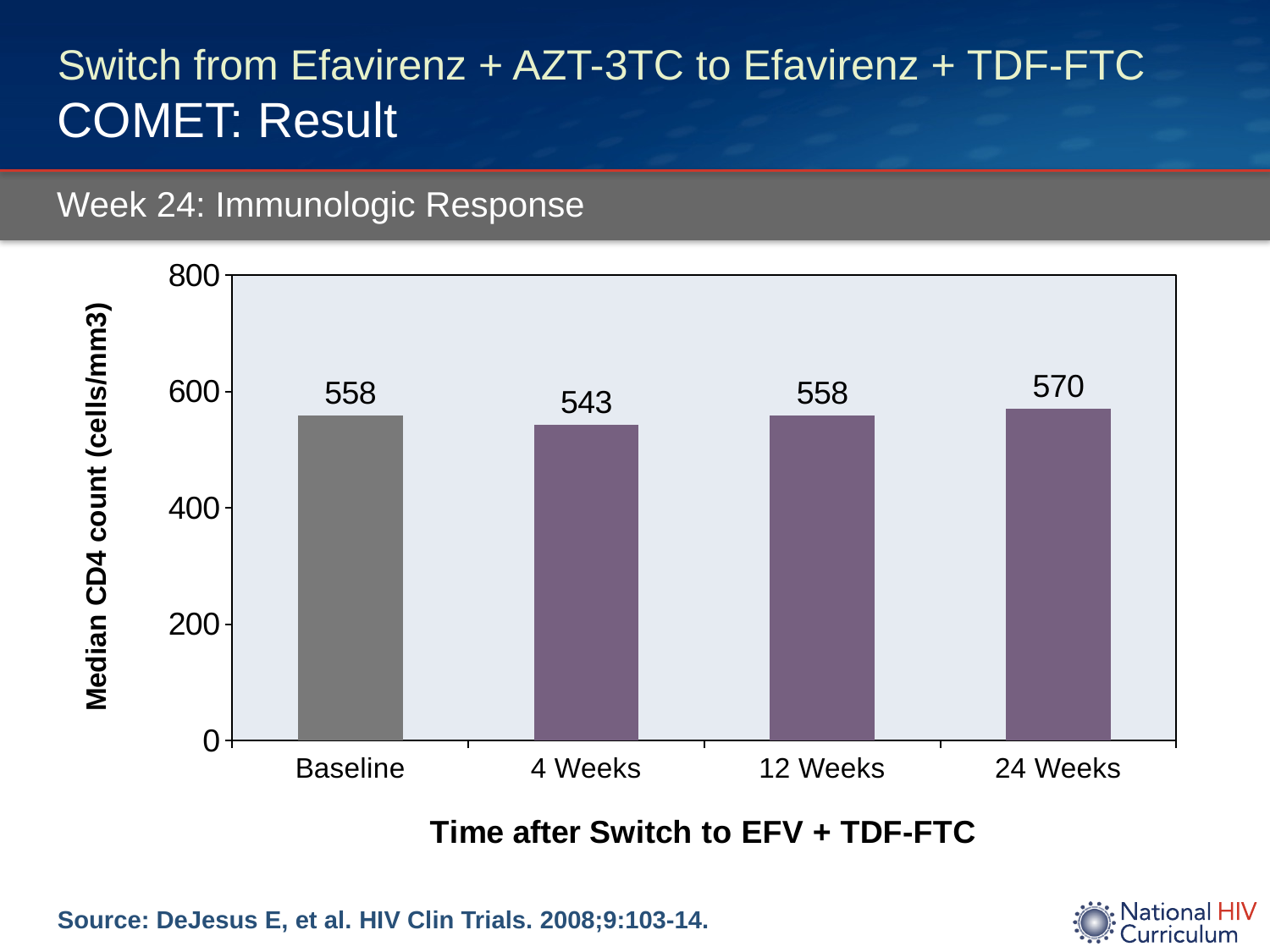
Which time point has the highest median CD4 count? 24 Weeks What is the label of the x axis? Time after Switch to EFV + TDF-FTC What is the difference in median CD4 count between 24 Weeks and 4 Weeks? 27 What is the median CD4 count at 4 Weeks? 543 What is the median CD4 count at 24 Weeks? 570 Which time point has the lowest median CD4 count? 4 Weeks How many time points are shown on the x axis? 4 What is the median CD4 count at Baseline? 558 Which has a larger median CD4 count, 24 Weeks or 12 Weeks? 24 Weeks What is the difference in median CD4 count between Baseline and 4 Weeks? 15 What kind of chart is shown on the slide? Bar chart What is the median CD4 count at 12 Weeks? 558